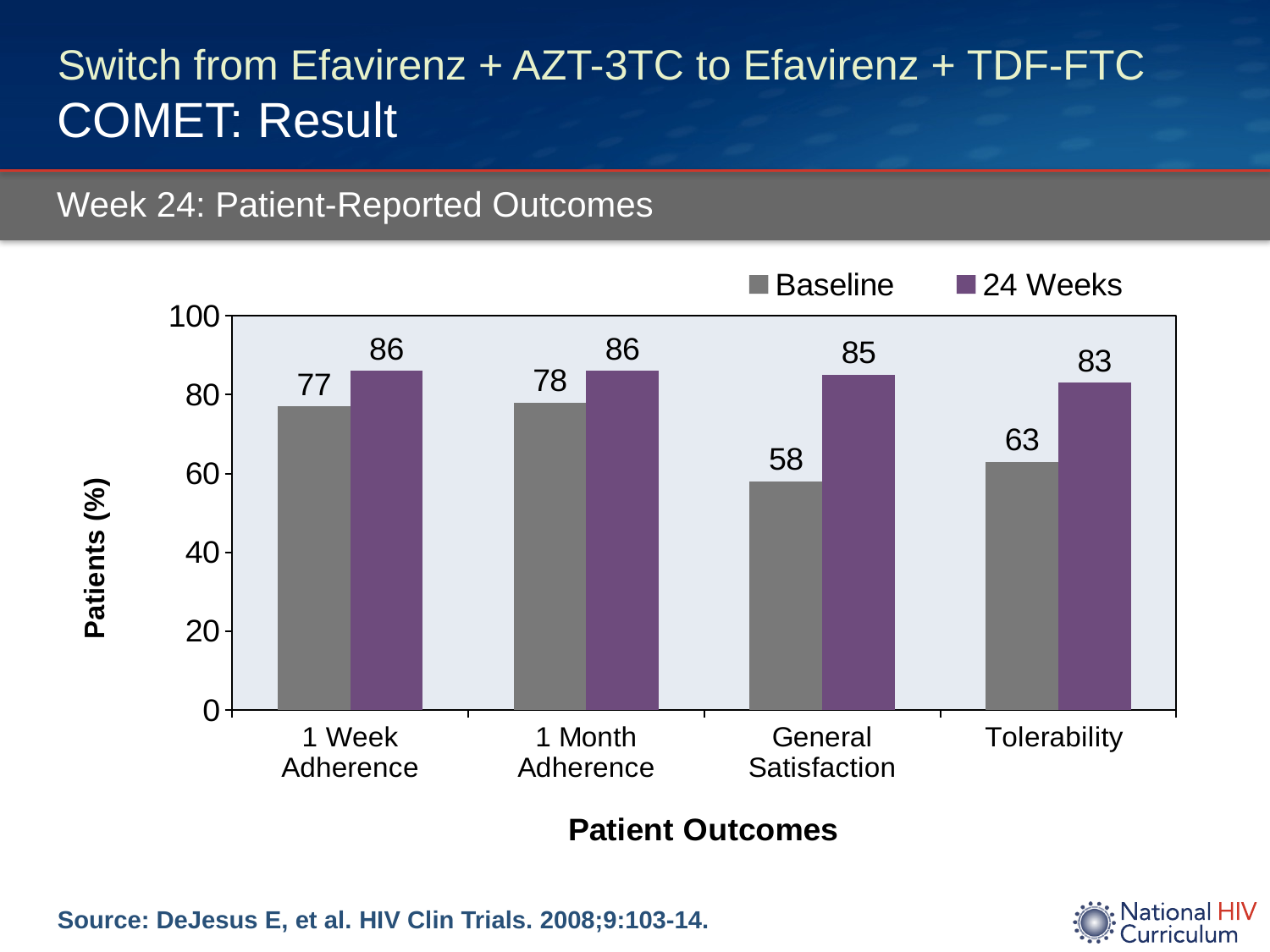
What is the Baseline value for General Satisfaction? 58 Which is larger, the Baseline value for 1 Week Adherence or the Baseline value for Tolerability? 1 Week Adherence Which category has the lowest 24 Weeks value? Tolerability What is the difference between the 24 Weeks and Baseline values for Tolerability? 20 What is the label of the y axis? Patients (%) What is the 24 Weeks value for Tolerability? 83 What is the Baseline value for 1 Month Adherence? 78 How many categories are shown on the x axis? 4 What is the difference between the 24 Weeks and Baseline values for General Satisfaction? 27 What kind of chart is shown on the slide? Bar chart Which category has the lowest Baseline value? General Satisfaction How many series does the legend list? 2